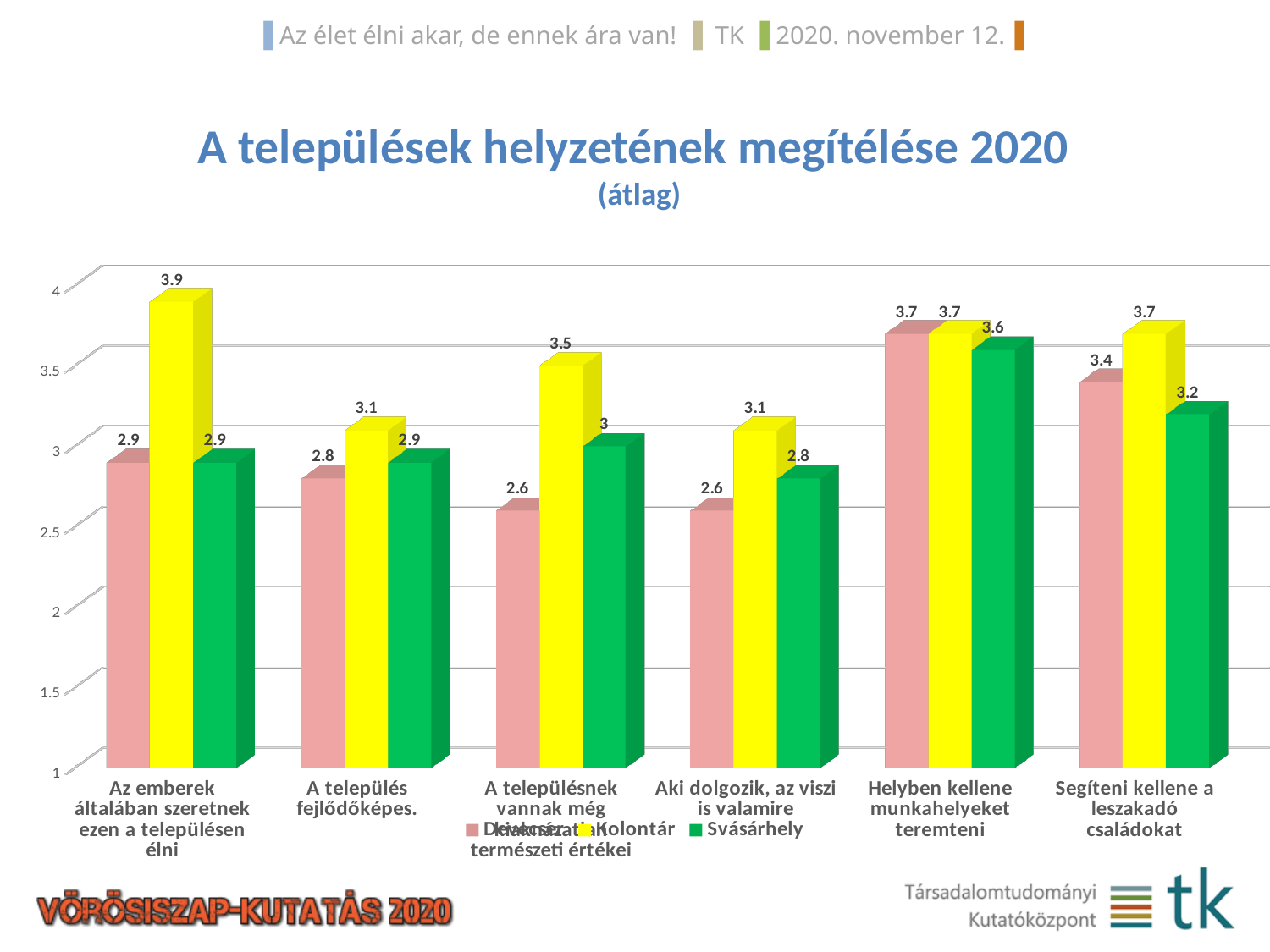
What kind of chart is shown on the slide? bar chart What is the Svásárhely value for "Aki dolgozik, az viszi is valamire"? 2.8 Which category has the lowest Svásárhely value? Aki dolgozik, az viszi is valamire How many categories are shown on the x axis? 6 How many series does the legend list? 3 Which category has the highest Kolontár value? Az emberek általában szeretnek ezen a településen élni What is the Kolontár value for "Az emberek általában szeretnek ezen a településen élni"? 3.9 What is the Svásárhely value for "Segíteni kellene a leszakadó családokat"? 3.2 Is the Svásárhely value for "Helyben kellene munkahelyeket teremteni" greater or less than 3? greater What is the Kolontár value for "A településnek vannak még kiaknázatlan természeti értékei"? 3.5 What is the difference between the Kolontár and Svásárhely values for "Az emberek általában szeretnek ezen a településen élni"? 1 For "A település fejlődőképes.", which is larger: the Kolontár value or the Svásárhely value? Kolontár